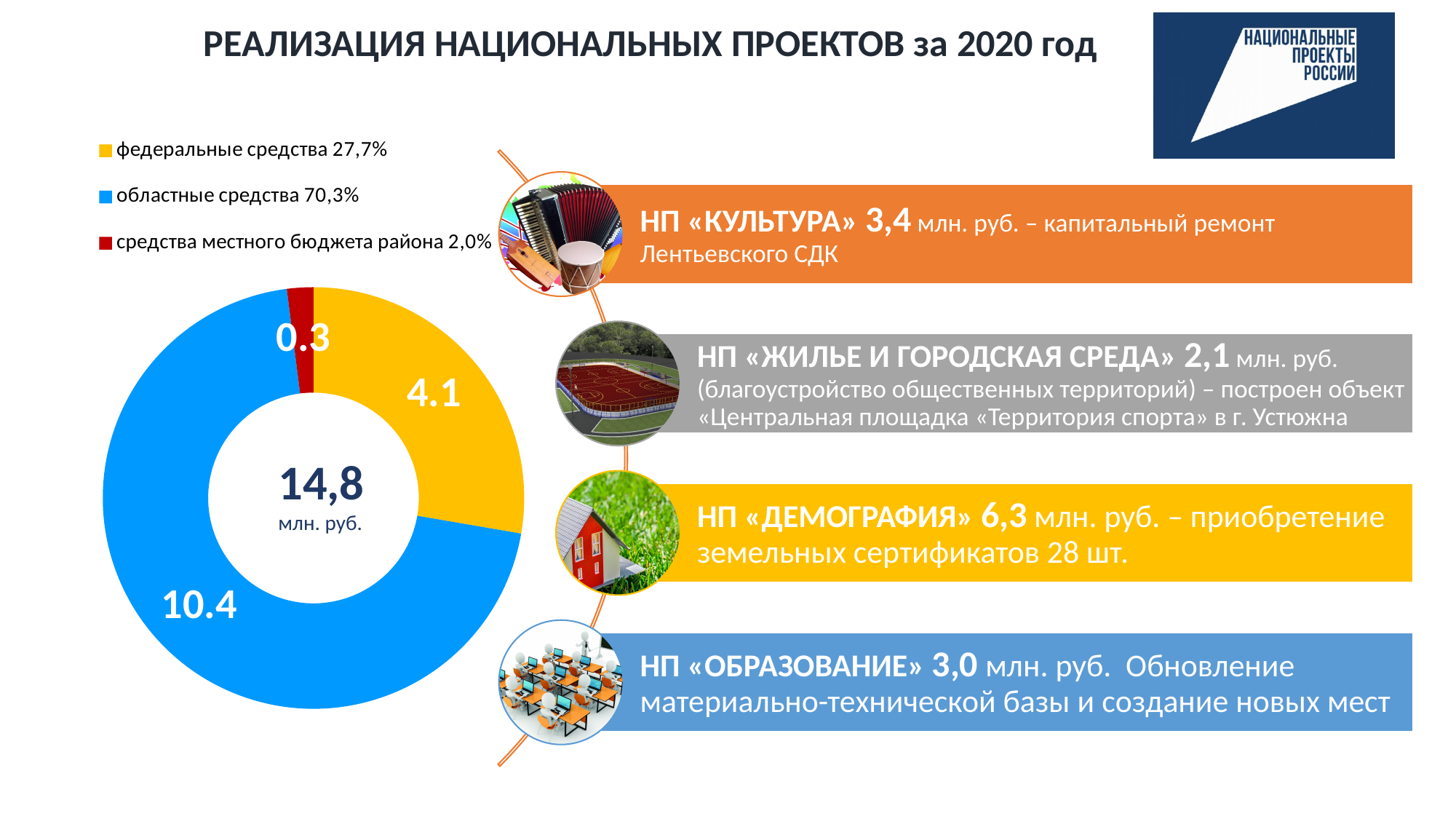
What total is shown in the centre of the pie chart? 14,8 млн. руб. What is the value for средства местного бюджета района on the pie chart? 0.3 How many categories are shown in the pie chart? 3 What share of the pie does федеральные средства represent, according to the legend? 27,7% What kind of chart is shown on the slide? doughnut chart What is the value for федеральные средства on the pie chart? 4.1 What share of the pie does областные средства represent, according to the legend? 70,3% Which category has the largest slice of the pie chart? областные средства What is the difference between the values for областные средства and федеральные средства? 6.3 What is the value for областные средства on the pie chart? 10.4 Which is larger: федеральные средства or средства местного бюджета района? федеральные средства Which category has the smallest slice of the pie chart? средства местного бюджета района